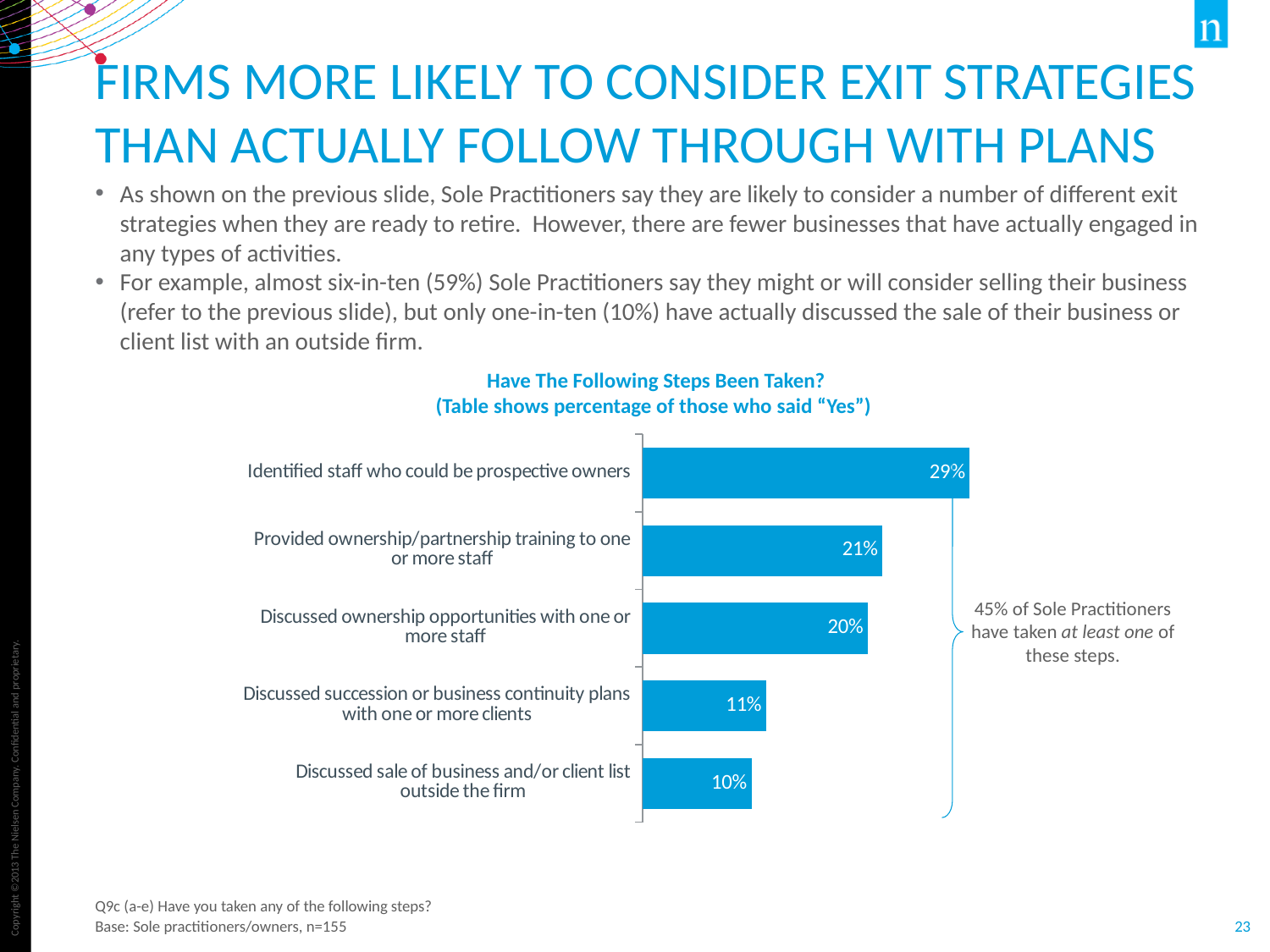
What percentage have provided ownership/partnership training to one or more staff? 21% Which step has the highest percentage of 'Yes' responses? Identified staff who could be prospective owners Which is larger: the percentage for 'Provided ownership/partnership training to one or more staff' or for 'Discussed succession or business continuity plans with one or more clients'? Provided ownership/partnership training to one or more staff What percentage of Sole Practitioners have identified staff who could be prospective owners? 29% What is the difference in percentage points between 'Identified staff who could be prospective owners' and 'Discussed ownership opportunities with one or more staff'? 9 percentage points How many steps (categories) are shown in the chart? 5 Which step has the lowest percentage of 'Yes' responses? Discussed sale of business and/or client list outside the firm What percentage have discussed sale of business and/or client list outside the firm? 10% What percentage have discussed succession or business continuity plans with one or more clients? 11% According to the annotation next to the chart, what percentage of Sole Practitioners have taken at least one of these steps? 45% What type of chart is shown on the slide? Bar chart What is the title of the chart? Have The Following Steps Been Taken? (Table shows percentage of those who said "Yes")